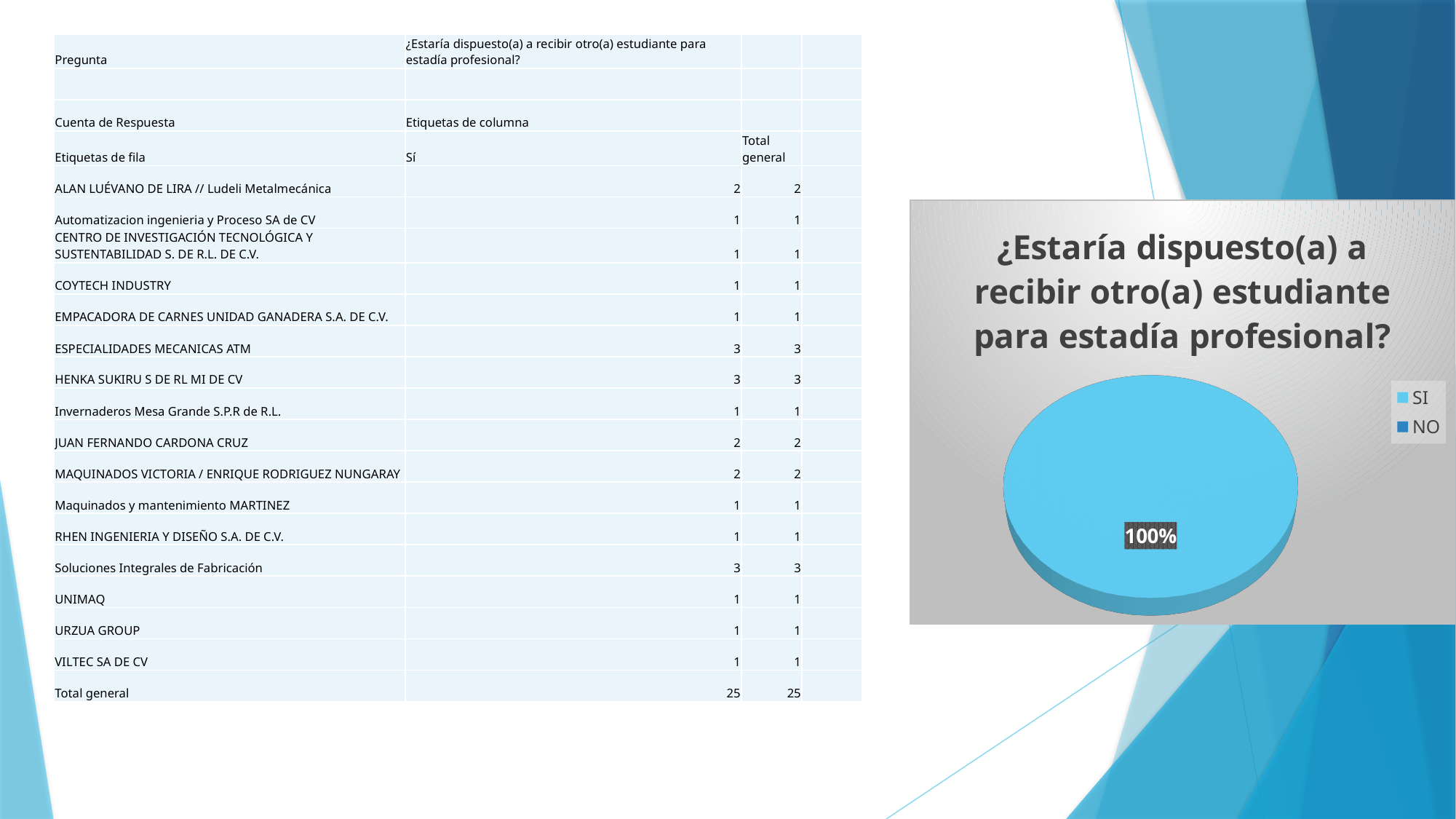
Is the share for SI greater or less than 50%? greater Which of the two legend categories, SI or NO, has the larger share of the pie? SI Which category has the largest slice of the pie? SI What colour is the SI slice in the pie chart? light blue What is the data label shown on the pie chart? 100% What kind of chart is shown on the slide? pie chart How many entries does the legend of the pie chart list? 2 What is the title of the pie chart? ¿Estaría dispuesto(a) a recibir otro(a) estudiante para estadía profesional? What share of the pie does the SI slice represent? 100%